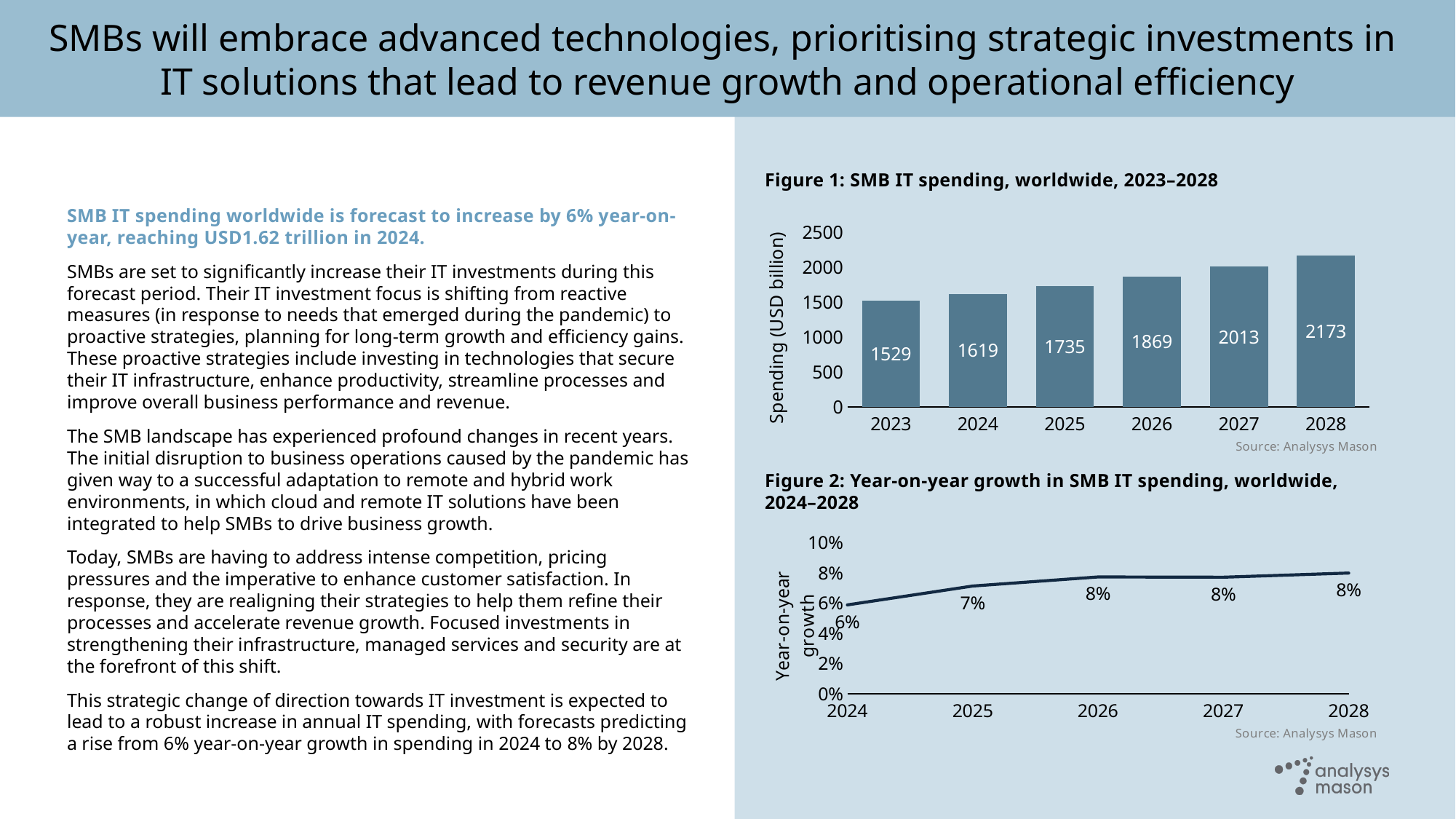
In Figure 1 (SMB IT spending, worldwide, 2023–2028), which year has the highest spending? 2028 In Figure 1 (SMB IT spending, worldwide, 2023–2028), what is the spending value for 2024? 1619 In Figure 1 (SMB IT spending, worldwide, 2023–2028), what kind of chart is used? Bar chart In Figure 2 (Year-on-year growth in SMB IT spending, worldwide, 2024–2028), what kind of chart is used? Line chart In Figure 1 (SMB IT spending, worldwide, 2023–2028), which year has the lowest spending? 2023 In Figure 1 (SMB IT spending, worldwide, 2023–2028), what is the difference between the 2028 and 2023 spending values? 644 In Figure 1 (SMB IT spending, worldwide, 2023–2028), how many years are shown on the x axis? 6 In Figure 1 (SMB IT spending, worldwide, 2023–2028), what is the spending value for 2027? 2013 In Figure 1 (SMB IT spending, worldwide, 2023–2028), do the values rise or fall from 2023 to 2028? Rise In Figure 2 (Year-on-year growth in SMB IT spending, worldwide, 2024–2028), what is the growth value for 2025? 7% In Figure 1 (SMB IT spending, worldwide, 2023–2028), what is the label on the y axis? Spending (USD billion) In Figure 2 (Year-on-year growth in SMB IT spending, worldwide, 2024–2028), what is the growth value for 2024? 6%